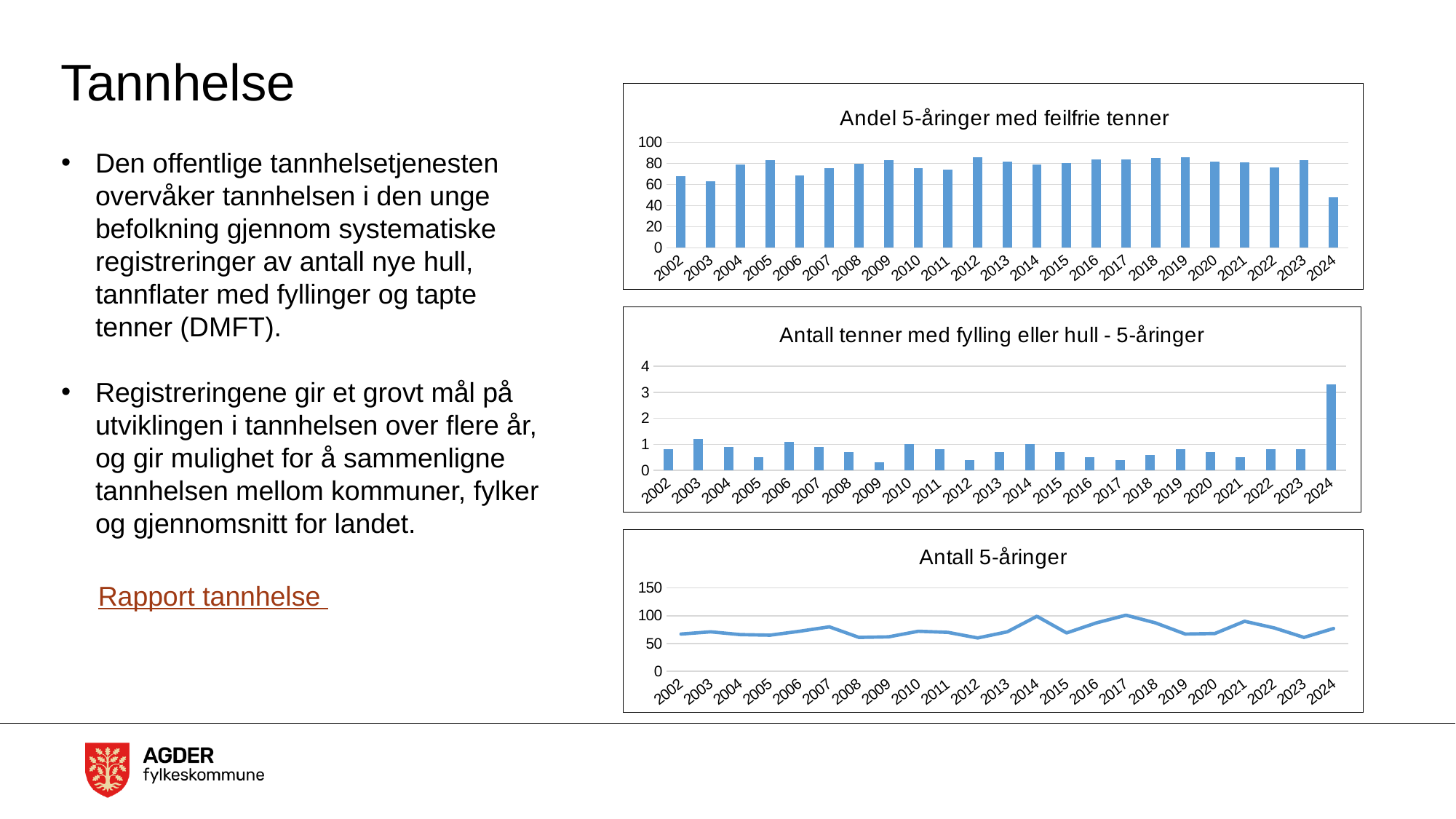
How many years are plotted in the middle chart "Antall tenner med fylling eller hull - 5-åringer"? 23 What type of chart is the bottom chart titled "Antall 5-åringer"? line chart In the middle chart "Antall tenner med fylling eller hull - 5-åringer", which year has the highest value? 2024 In the top chart "Andel 5-åringer med feilfrie tenner", is the value for 2024 greater or less than 60? less What type of chart is the top chart titled "Andel 5-åringer med feilfrie tenner"? bar chart In the bottom chart "Antall 5-åringer", which is larger, the value for 2014 or the value for 2023? 2014 In the top chart "Andel 5-åringer med feilfrie tenner", is the value for 2003 greater or less than 80? less In the top chart "Andel 5-åringer med feilfrie tenner", which year has the lowest value? 2024 In the bottom chart "Antall 5-åringer", is the value for 2023 greater or less than 100? less In the top chart "Andel 5-åringer med feilfrie tenner", which is larger, the value for 2023 or the value for 2024? 2023